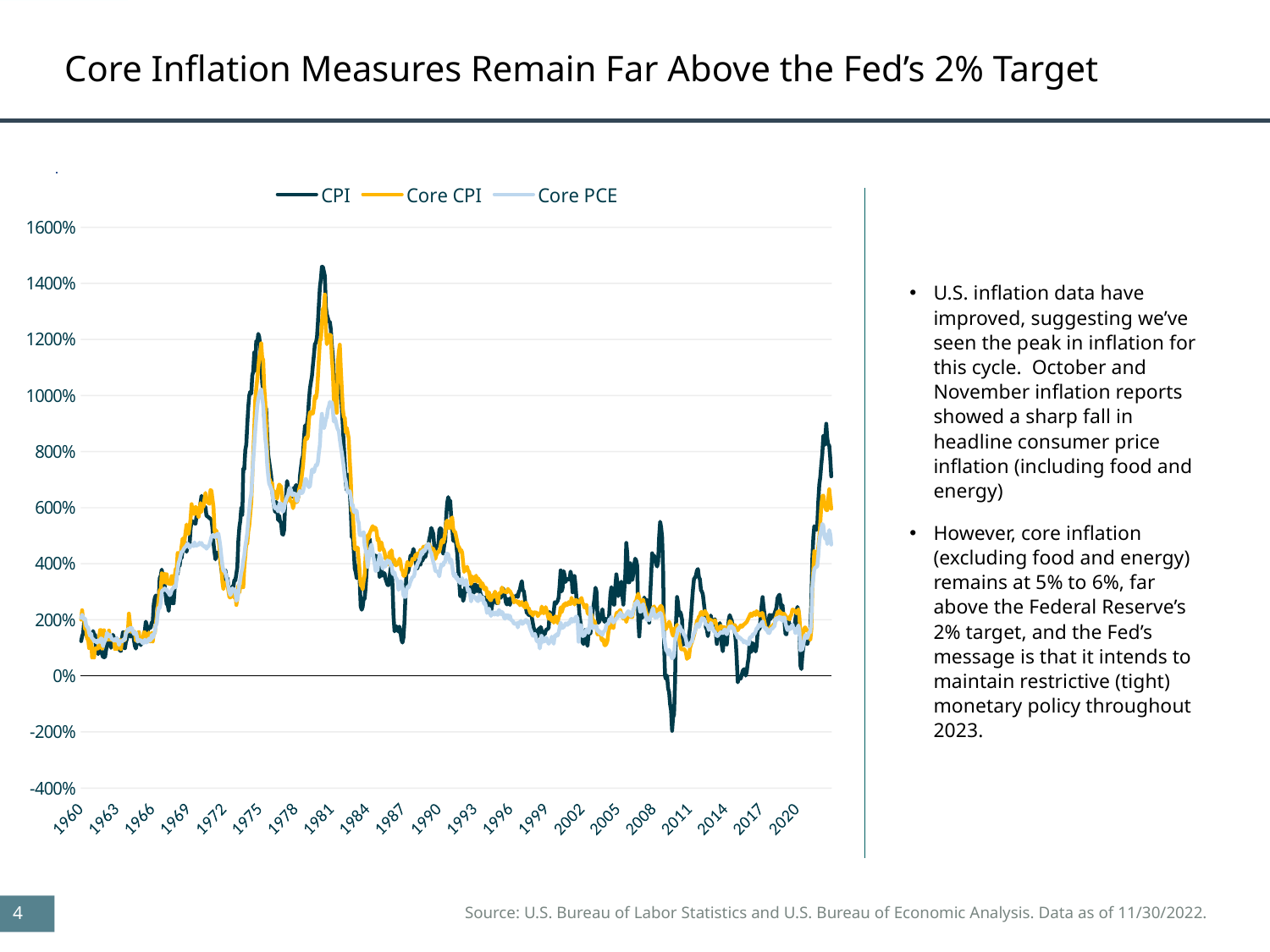
What is the first year labelled on the chart's x axis? 1960 How many series does the chart's legend list? 3 How many year labels are shown on the x axis of the chart? 21 Which series falls to the lowest value on the chart? CPI What are the three series named in the chart's legend? CPI, Core CPI, Core PCE Around 1980, which series is higher: CPI or Core PCE? CPI What is the highest value labelled on the chart's y axis? 1600% Is the peak value of CPI around 1980 greater or less than 1200%? greater Which series reaches the highest peak on the chart? CPI What kind of chart is shown on the slide? Line chart Is the lowest value of CPI around 2009 greater or less than 0%? less Is the peak value of Core PCE around 1980 greater or less than 1200%? less